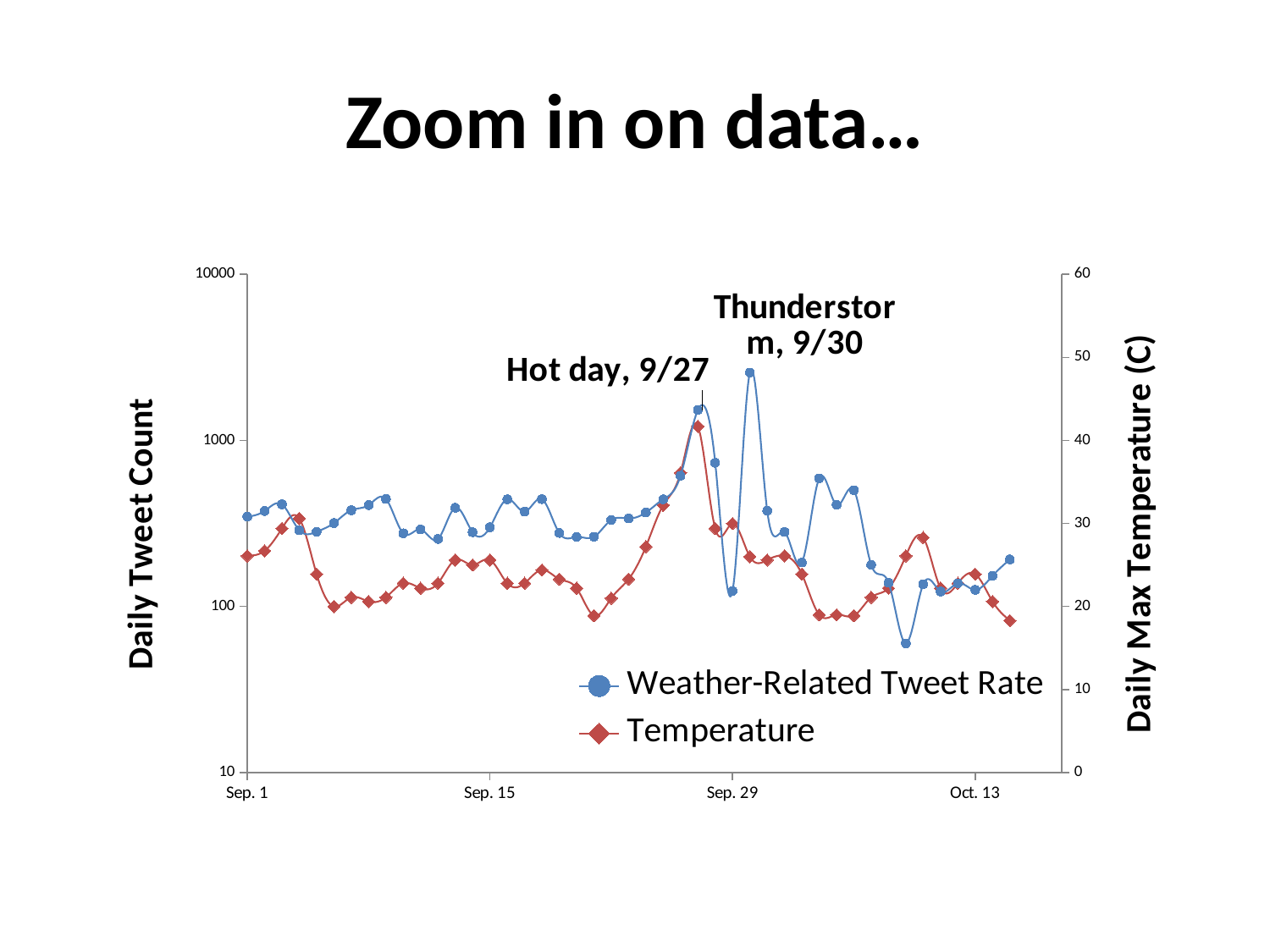
How many series does the legend list? 2 Is the Temperature on Oct. 13 greater or less than 30? less What is the title of the right-hand vertical axis? Daily Max Temperature (C) Is the Temperature on the hot day (9/27) greater or less than 30? greater Is the Weather-Related Tweet Rate on the thunderstorm day (9/30) greater or less than 1000? greater Which annotated event corresponds to the highest Weather-Related Tweet Rate on the chart? Thunderstorm, 9/30 Which is higher, the Weather-Related Tweet Rate on the hot day (9/27) or on the thunderstorm day (9/30)? Thunderstorm day (9/30) What are the two series named in the legend? Weather-Related Tweet Rate and Temperature Does the Temperature rise or fall between the hot day (9/27) and Sep. 29? Fall What kind of chart is shown on the slide? Line chart